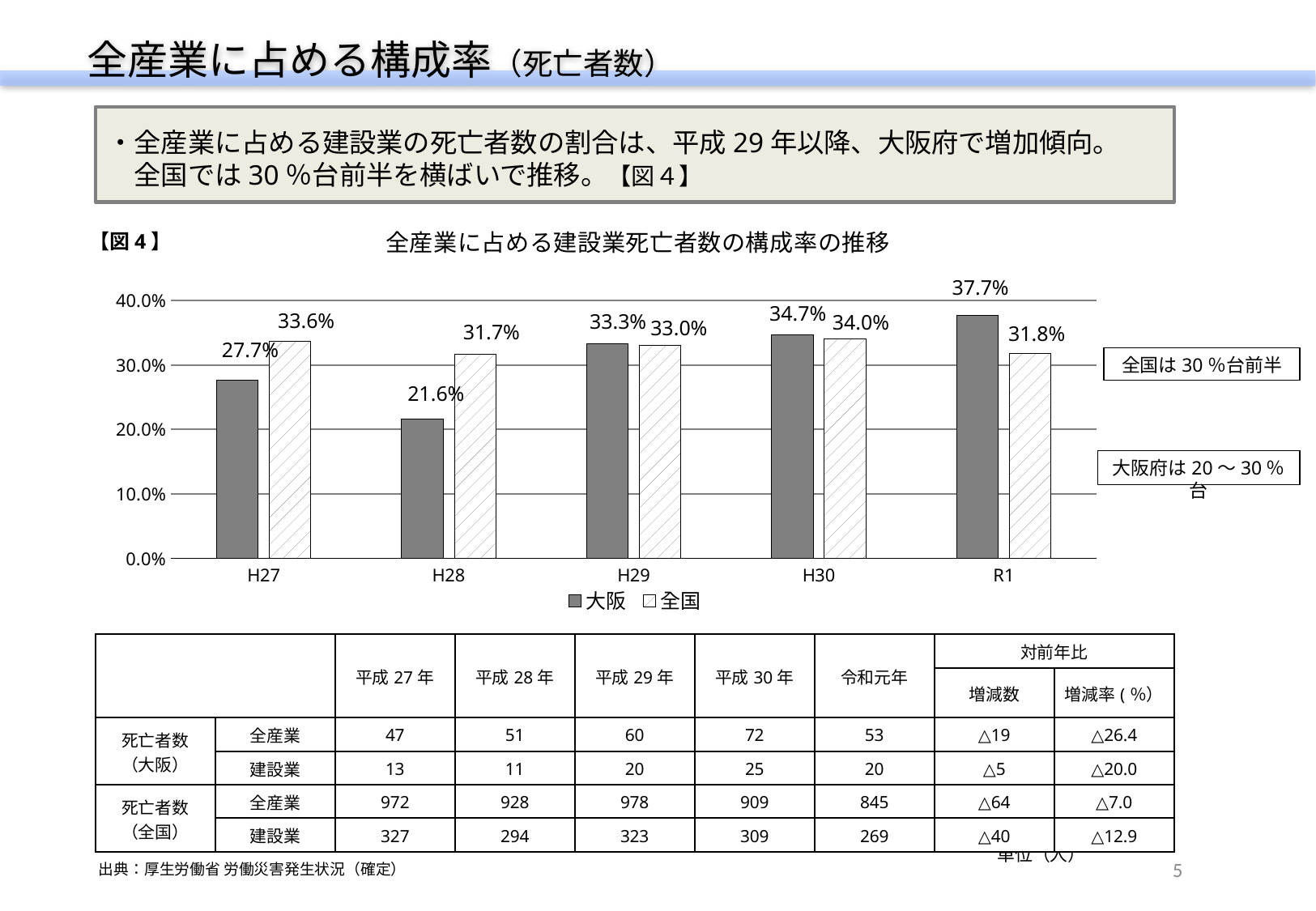
What kind of chart is shown? bar chart In which year is the 大阪 value lowest? H28 What is the value for 大阪 in H30? 34.7% Which is larger in H27, the 大阪 value or the 全国 value? 全国 What is the difference between the 大阪 and 全国 values in R1? 5.9% How many years are shown on the x axis? 5 How many series does the legend list? 2 What is the value for 全国 in R1? 31.8% In which year is the 大阪 value highest? R1 Does the 大阪 value rise or fall from H28 to R1? rise What is the value for 大阪 in H28? 21.6% Is the value for 大阪 in H28 greater or less than 30.0%? less